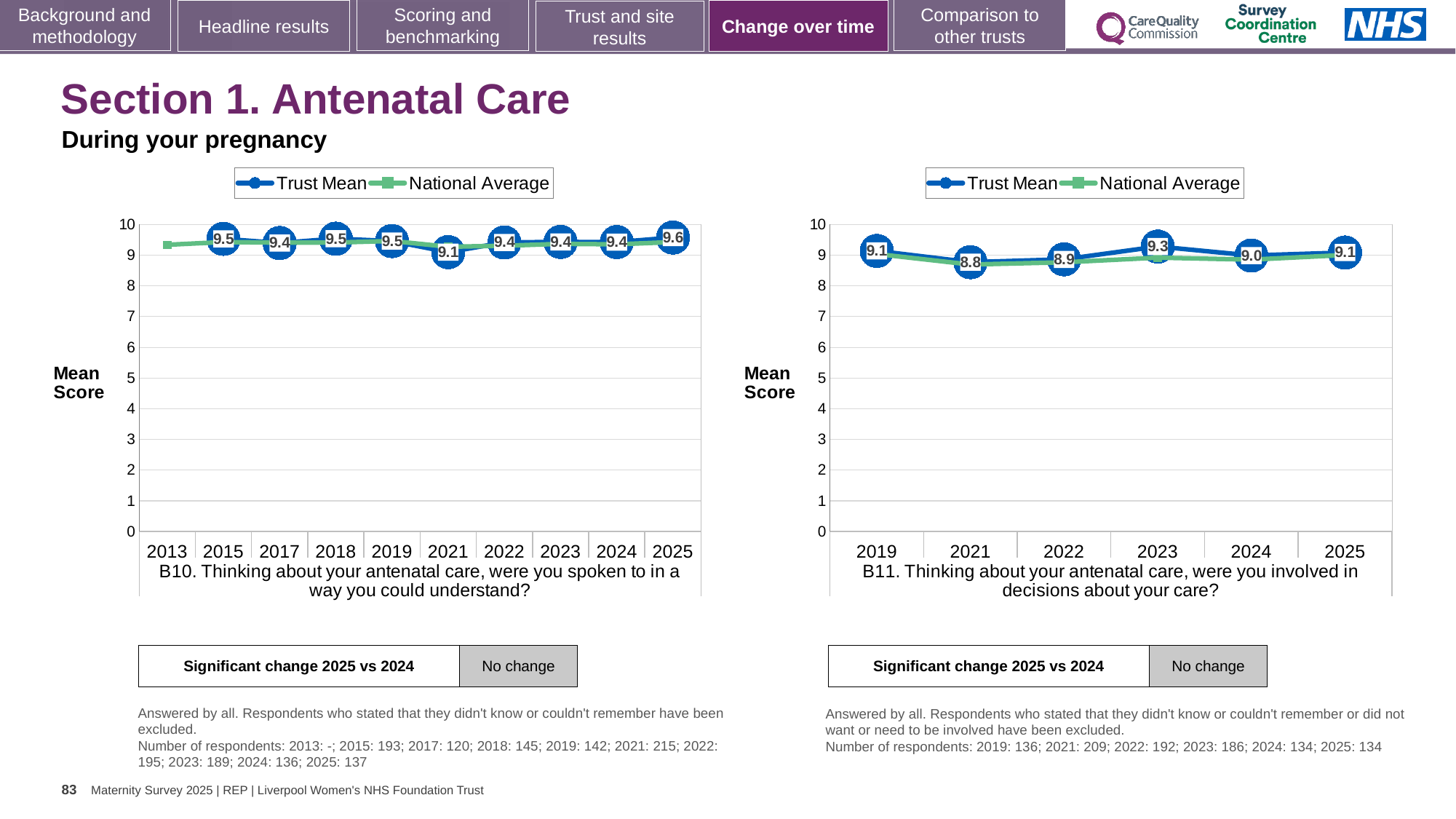
In the B10 chart (left), which year has the lowest Trust Mean? 2021 In the B10 chart (left), what is the Trust Mean for 2025? 9.6 How many years are shown on the x axis of the B11 chart (right)? 6 What kind of chart is the B11 chart (right)? Line chart In the B11 chart (right), is the Trust Mean higher in 2019 or in 2021? 2019 In the B11 chart (right), what is the Trust Mean for 2023? 9.3 In the B10 chart (left), what is the difference between the Trust Mean in 2025 and in 2021? 0.5 In the B11 chart (right), which year has the lowest Trust Mean? 2021 In the B10 chart (left), which year has the highest Trust Mean? 2025 In the B11 chart (right), which year has the highest Trust Mean? 2023 In the B10 chart (left), what is the Trust Mean for 2021? 9.1 How many series does the legend of the B10 chart (left) list? 2